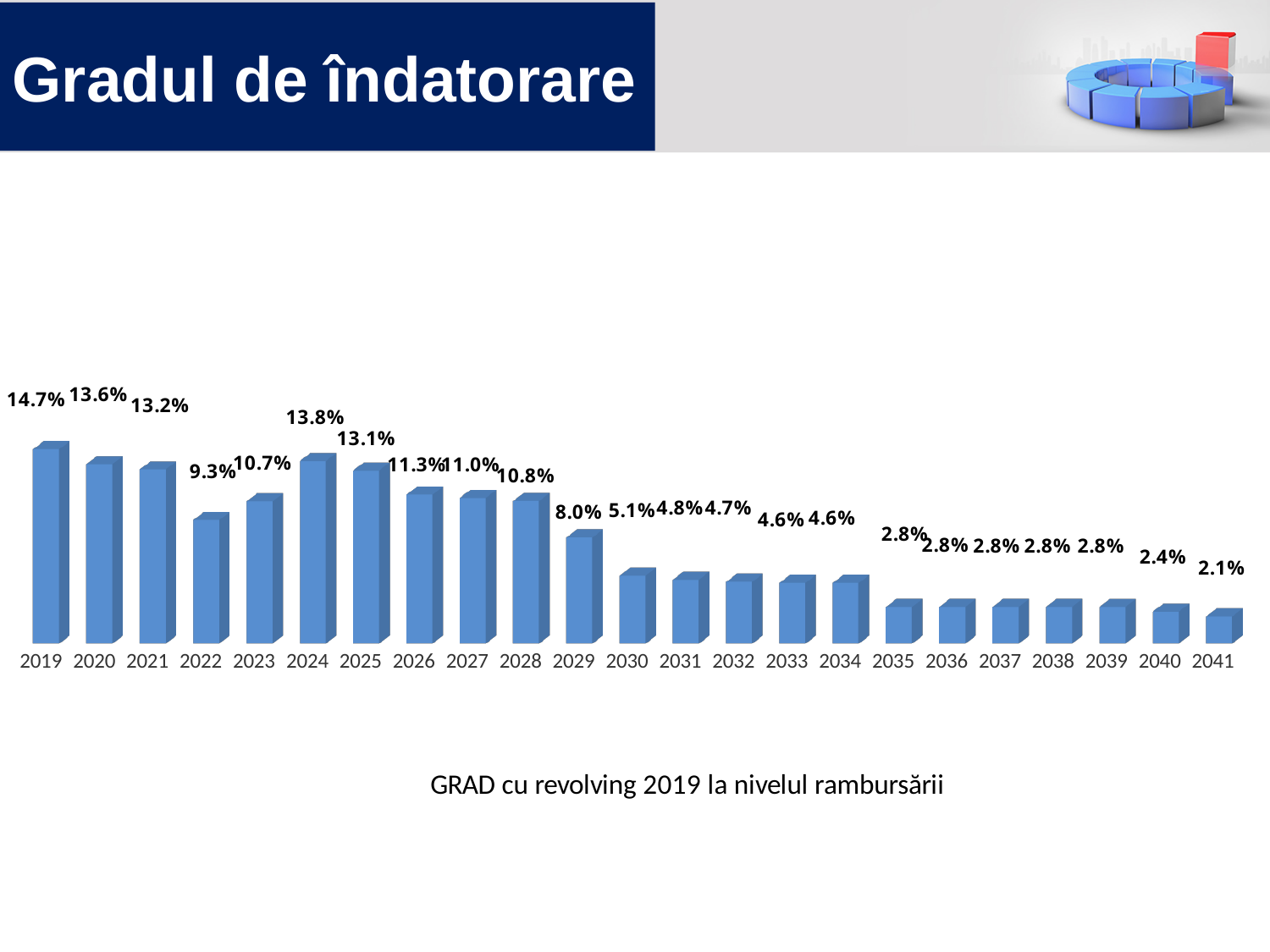
What is the difference between the values for 2029 and 2030? 2.9% What is the difference between the values for 2019 and 2020? 1.1% What is the value for 2024? 13.8% What kind of chart is shown on the slide? Bar chart What is the value for 2019? 14.7% Which year has the lowest value? 2041 Do the values generally rise or fall from 2019 to 2041? Fall Which year has the highest value? 2019 Which is larger, the value for 2022 or the value for 2023? 2023 How many years are shown on the x axis? 23 What is the value for 2041? 2.1% What is the value for 2029? 8.0%